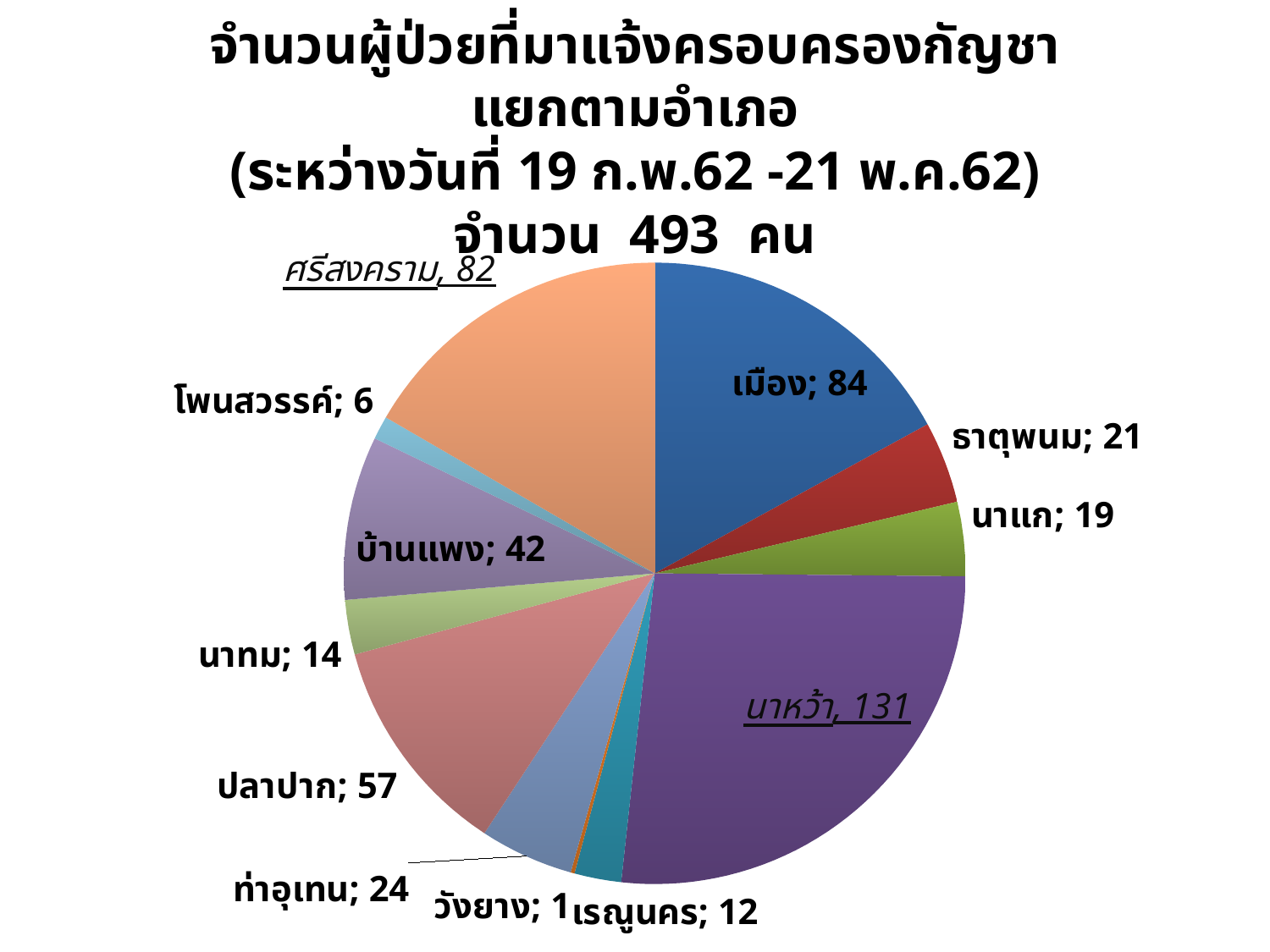
Which is larger, the value for บ้านแพง or the value for ท่าอุเทน? บ้านแพง How many districts (slices) are shown in the pie chart? 12 Which district has the largest slice? นาหว้า What total number of people is stated in the chart title? 493 คน Which district has the smallest slice? วังยาง What is the value for นาหว้า? 131 What is the difference between the values for ธาตุพนม and นาแก? 2 What is the value for ปลาปาก? 57 What date range is given in the chart title? 19 ก.พ.62 - 21 พ.ค.62 What type of chart is shown on the slide? pie chart What is the value for ศรีสงคราม? 82 What is the difference between the values for นาหว้า and เมือง? 47